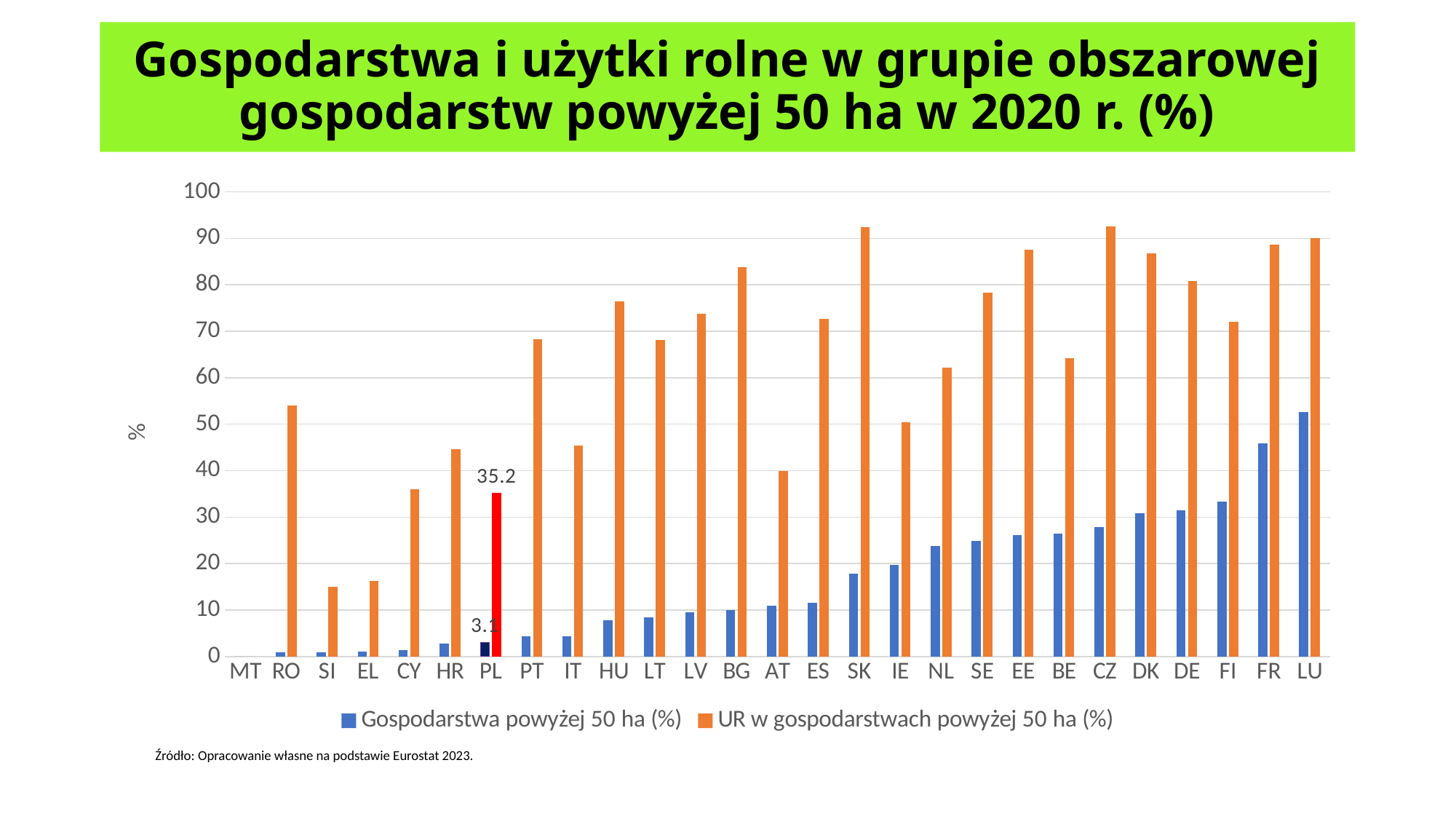
Which country has the highest value for Gospodarstwa powyżej 50 ha (%)? LU What colour represents the series UR w gospodarstwach powyżej 50 ha (%) in the legend? orange Do the values of Gospodarstwa powyżej 50 ha (%) generally rise or fall from left to right along the x axis? rise What is the value of Gospodarstwa powyżej 50 ha (%) for PL? 3.1 Which is larger, the UR w gospodarstwach powyżej 50 ha (%) value for HU or for IT? HU What is the difference between the UR w gospodarstwach powyżej 50 ha (%) value and the Gospodarstwa powyżej 50 ha (%) value for PL? 32.1 Is the value of UR w gospodarstwach powyżej 50 ha (%) for RO greater or less than 60? less What is the value of UR w gospodarstwach powyżej 50 ha (%) for PL? 35.2 Is the value of UR w gospodarstwach powyżej 50 ha (%) for LU greater or less than 80? greater How many countries are shown on the x axis of the chart? 27 How many series does the legend list? 2 What kind of chart is shown on the slide? bar chart